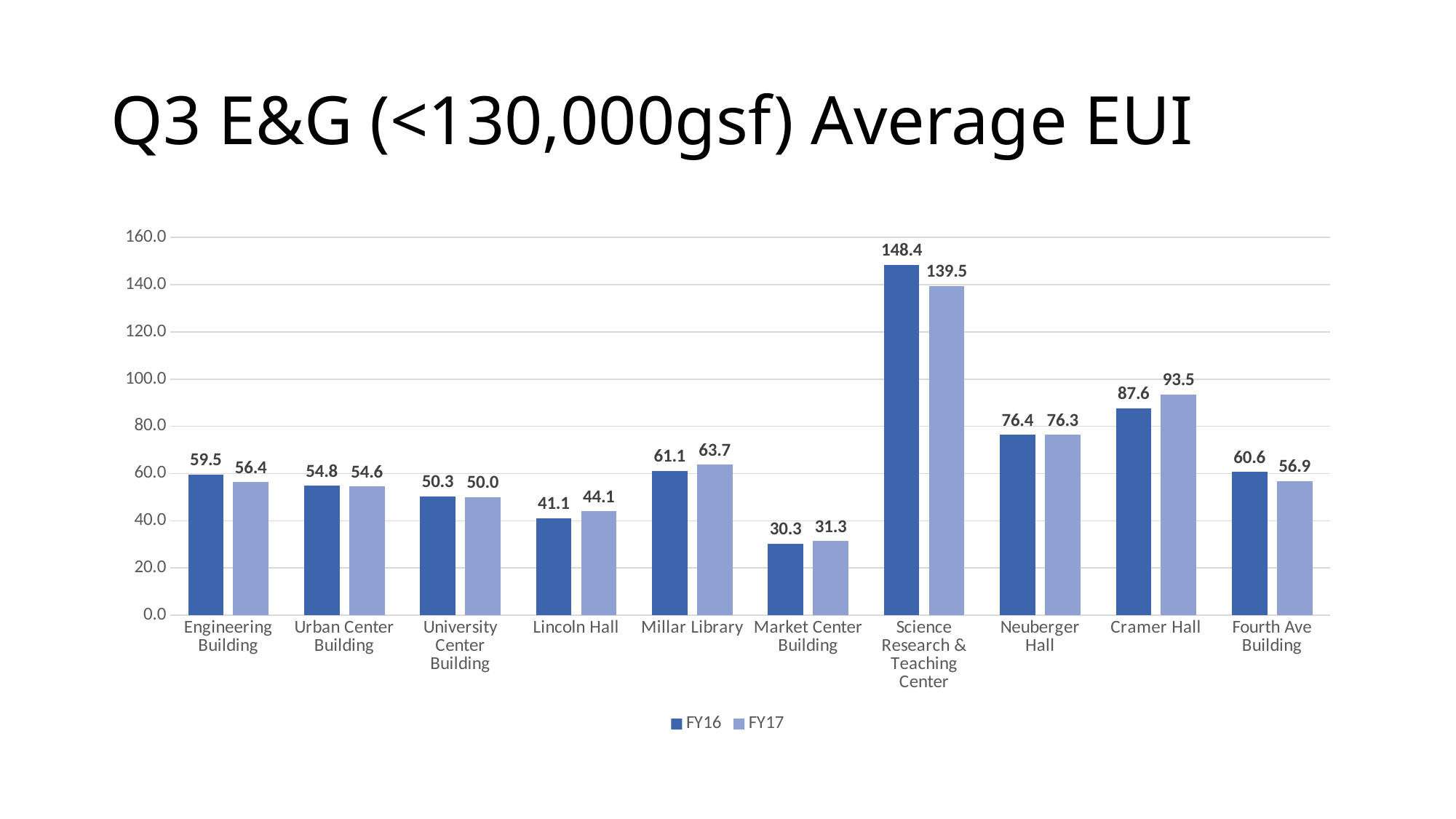
Which building has the highest FY17 value? Science Research & Teaching Center What is the difference between the FY16 and FY17 values for Science Research & Teaching Center? 8.9 What is the FY16 value for Market Center Building? 30.3 Is the FY16 value for Neuberger Hall greater or less than 60.0? greater Which is larger for Cramer Hall, the FY16 value or the FY17 value? FY17 Which building has the lowest FY16 value? Market Center Building How many buildings are shown on the x axis? 10 What is the FY17 value for Cramer Hall? 93.5 What is the title of the slide? Q3 E&G (<130,000gsf) Average EUI What is the FY16 value for Science Research & Teaching Center? 148.4 What kind of chart is shown on the slide? bar chart How many series does the legend list? 2